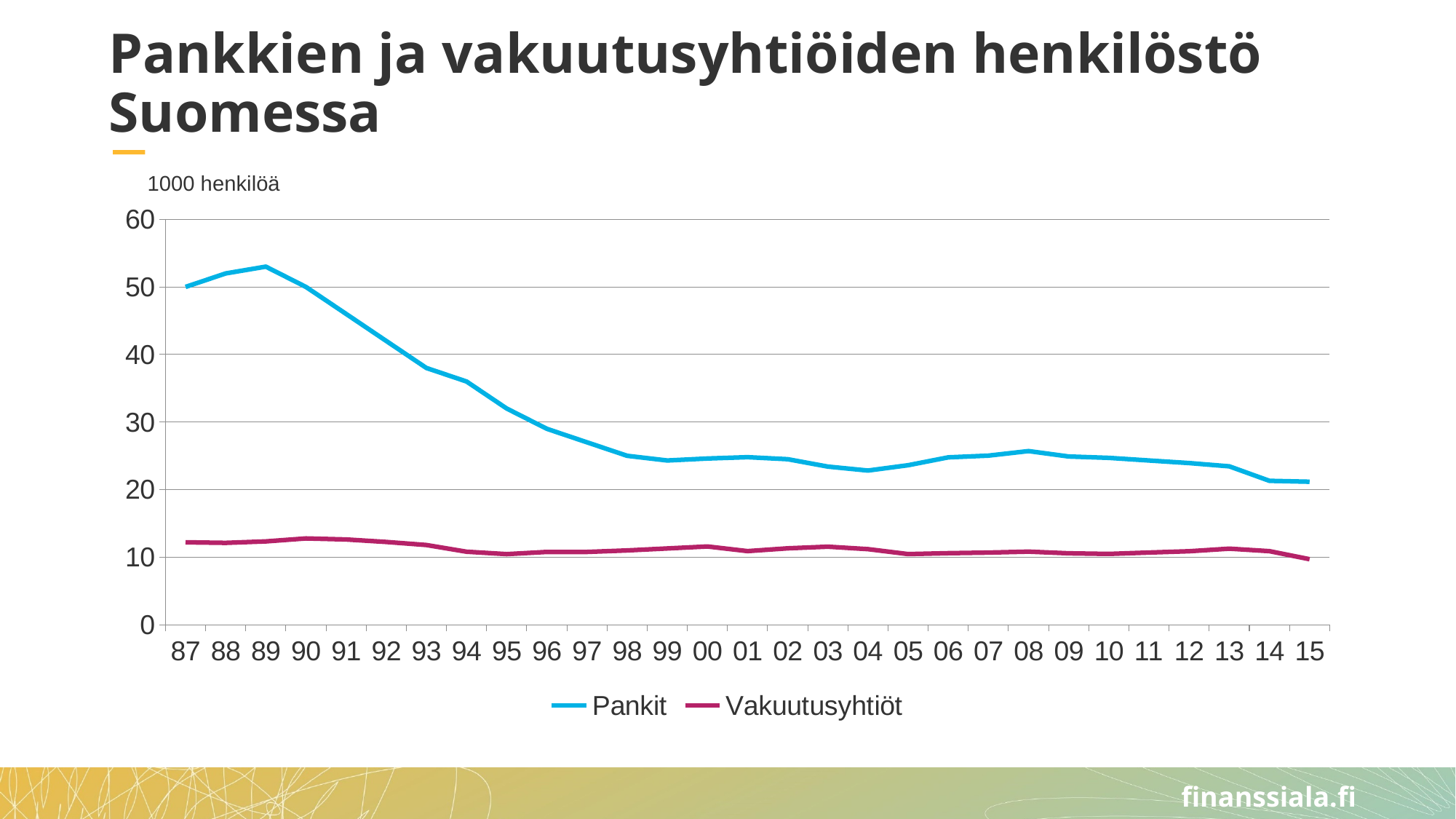
Does the Pankit series overall rise or fall from 87 to 15? fall Is the value for Pankit in 89 greater or less than 50? greater Is the value for Pankit in 15 greater or less than 20? greater How many years are shown on the x axis? 29 In which year does the Pankit series reach its highest value? 89 In which year does the Vakuutusyhtiöt series reach its lowest value? 15 How many series does the legend list? 2 What unit is stated above the y axis of the chart? 1000 henkilöä What kind of chart is shown on the slide? line chart Is the value for Pankit in 93 greater or less than 40? less Which series has the larger value in 87, Pankit or Vakuutusyhtiöt? Pankit